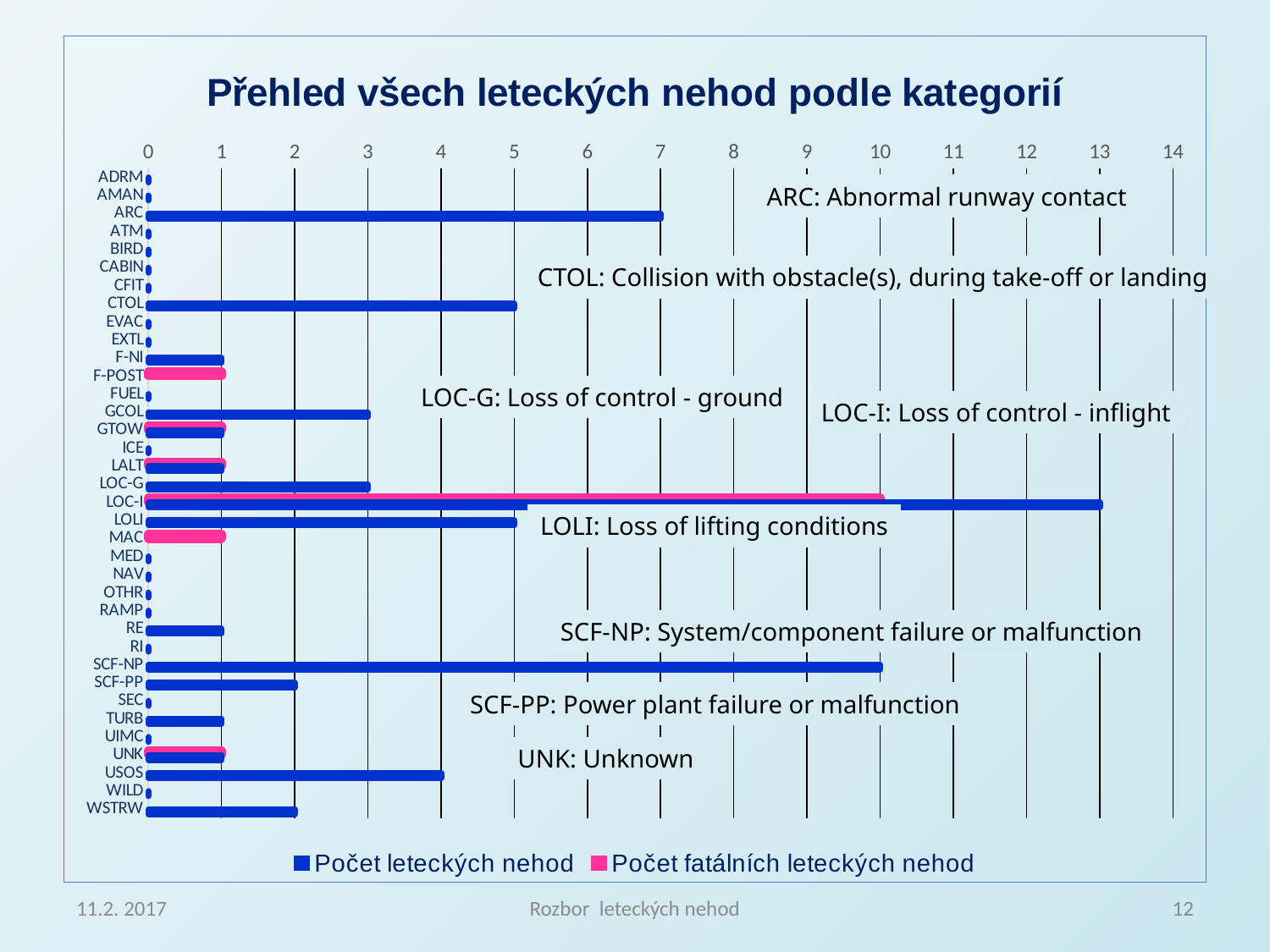
What is the value of Počet leteckých nehod for ARC? 7 What is the title of the chart? Přehled všech leteckých nehod podle kategorií What is the value of Počet fatálních leteckých nehod for LOC-I? 10 Which has a larger Počet leteckých nehod value, ARC or CTOL? ARC Is the Počet leteckých nehod value for USOS greater or less than 3? greater What is the value of Počet leteckých nehod for LOC-I? 13 What is the difference between Počet leteckých nehod for LOC-I and for SCF-NP? 3 What is the value of Počet leteckých nehod for SCF-NP? 10 What type of chart is shown on the slide? bar chart How many categories are listed on the vertical axis of the chart? 36 Which category has the highest number of accidents (Počet leteckých nehod)? LOC-I How many series does the legend list? 2